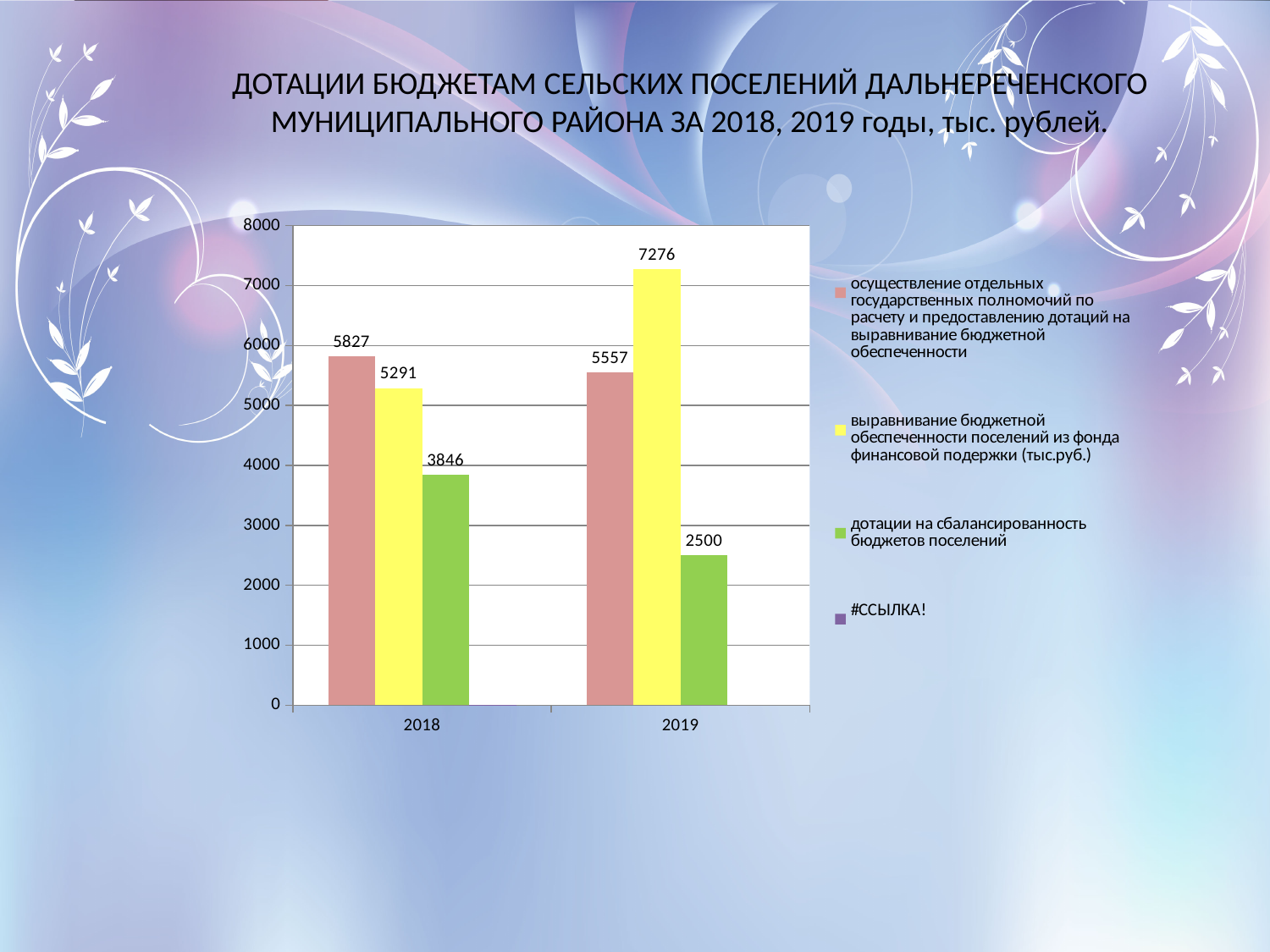
Did the green bar (дотации на сбалансированность бюджетов поселений) rise or fall from 2018 to 2019? fall Which bar has the lowest value on the chart? 2500 (green bar, 2019) Which bar has the highest value on the chart? 7276 (yellow bar, 2019) Is the green bar for 2019 greater or less than 3000? less Which is larger: the pink bar for 2018 or the pink bar for 2019? 2018 (5827) How many year categories are shown on the x axis? 2 What type of chart is shown on the slide? bar chart What is the value of the pink bar (осуществление отдельных государственных полномочий...) for 2019? 5557 What is the value of the green bar (дотации на сбалансированность бюджетов поселений) for 2018? 3846 What is the value of the yellow bar (выравнивание бюджетной обеспеченности поселений из фонда финансовой подержки) for 2019? 7276 How many entries does the legend list? 4 What is the difference between the yellow bar values for 2019 and 2018? 1985